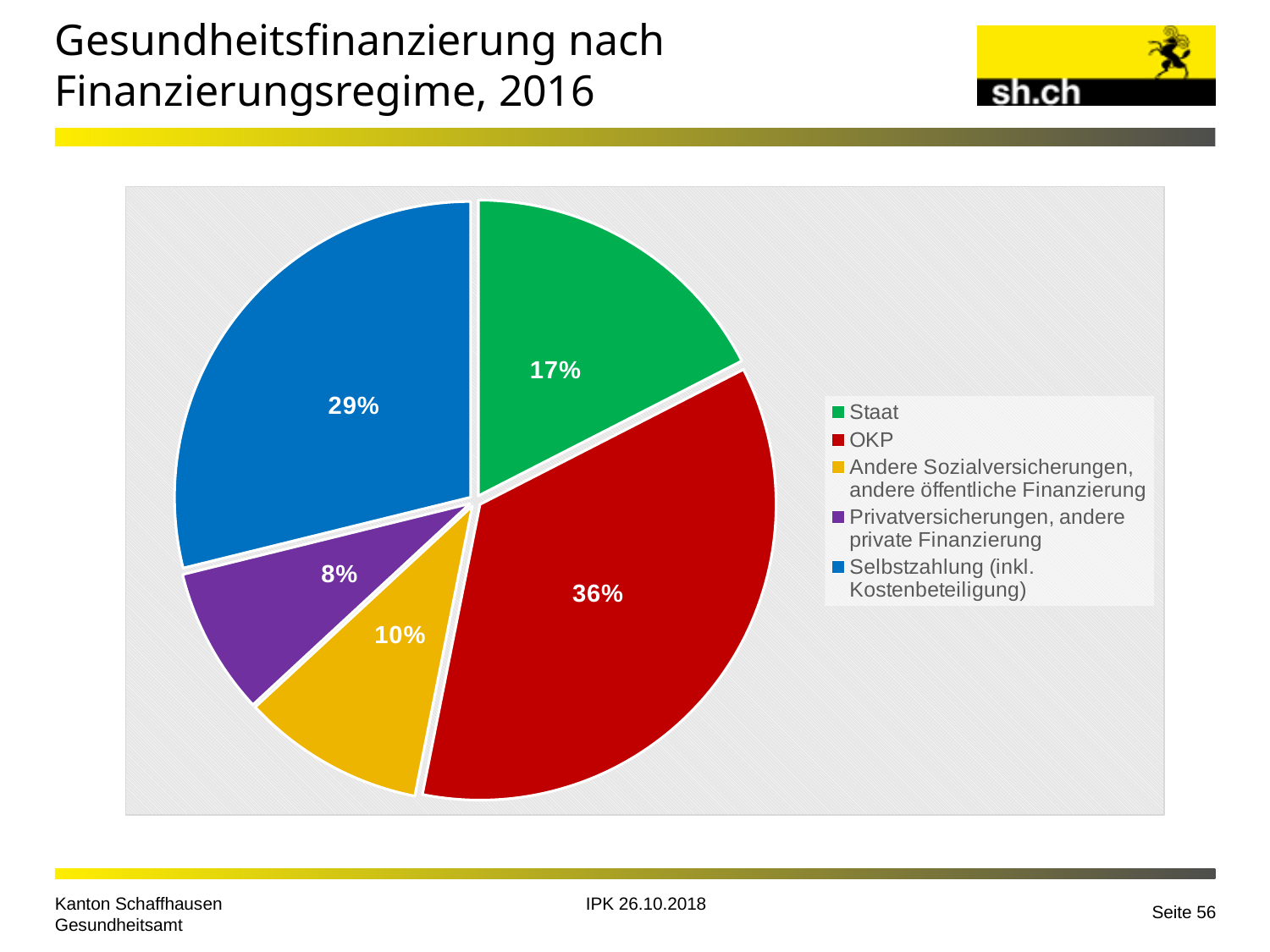
Which is larger, the share for Staat or the share for Selbstzahlung (inkl. Kostenbeteiligung)? Selbstzahlung (inkl. Kostenbeteiligung) What share does Andere Sozialversicherungen, andere öffentliche Finanzierung account for? 10% Which financing regime has the largest share? OKP How many slices does the pie chart have? 5 What colour is the OKP slice? red Which financing regime has the smallest share? Privatversicherungen, andere private Finanzierung What kind of chart is shown on the slide? pie chart What share does Privatversicherungen, andere private Finanzierung account for? 8% What share of health financing does Staat account for? 17% What share of health financing does OKP account for? 36% What is the difference in percentage points between OKP and Selbstzahlung (inkl. Kostenbeteiligung)? 7 percentage points What share does Selbstzahlung (inkl. Kostenbeteiligung) account for? 29%